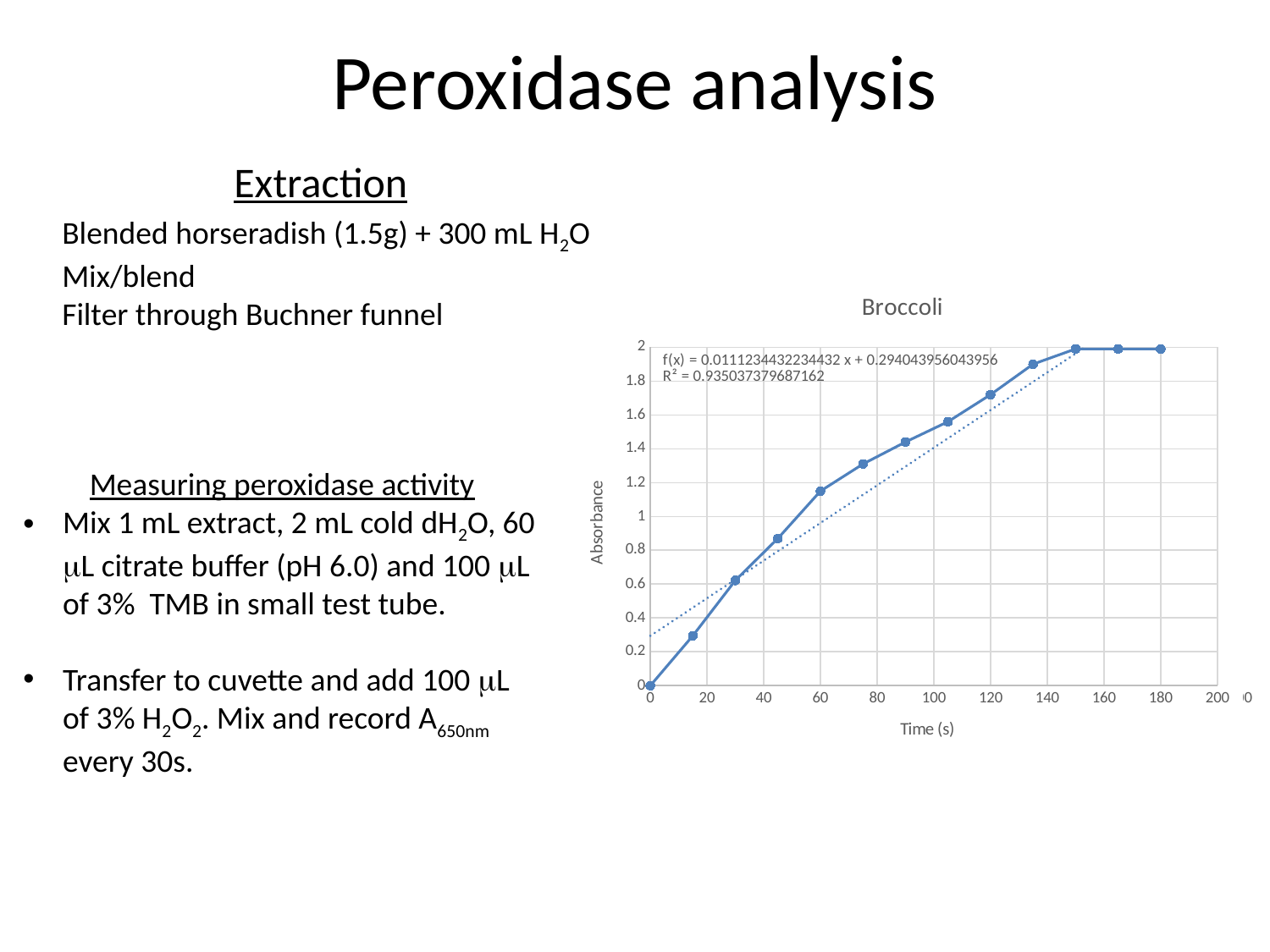
Does absorbance rise or fall as time increases from 0 to 150 s? rise Is the absorbance at 120 s greater or less than 1.6? greater What is the title of the chart? Broccoli Which is larger, the absorbance at 90 s or at 45 s? 90 s Is the absorbance at 30 s greater or less than 0.8? less What is the absorbance value at time 0? 0 At which time is the absorbance lowest? 0 What kind of chart is shown on the slide? line chart Is the absorbance at 60 s greater or less than 1? greater What is the label of the x axis of the chart? Time (s) How many data points are plotted on the Broccoli line? 13